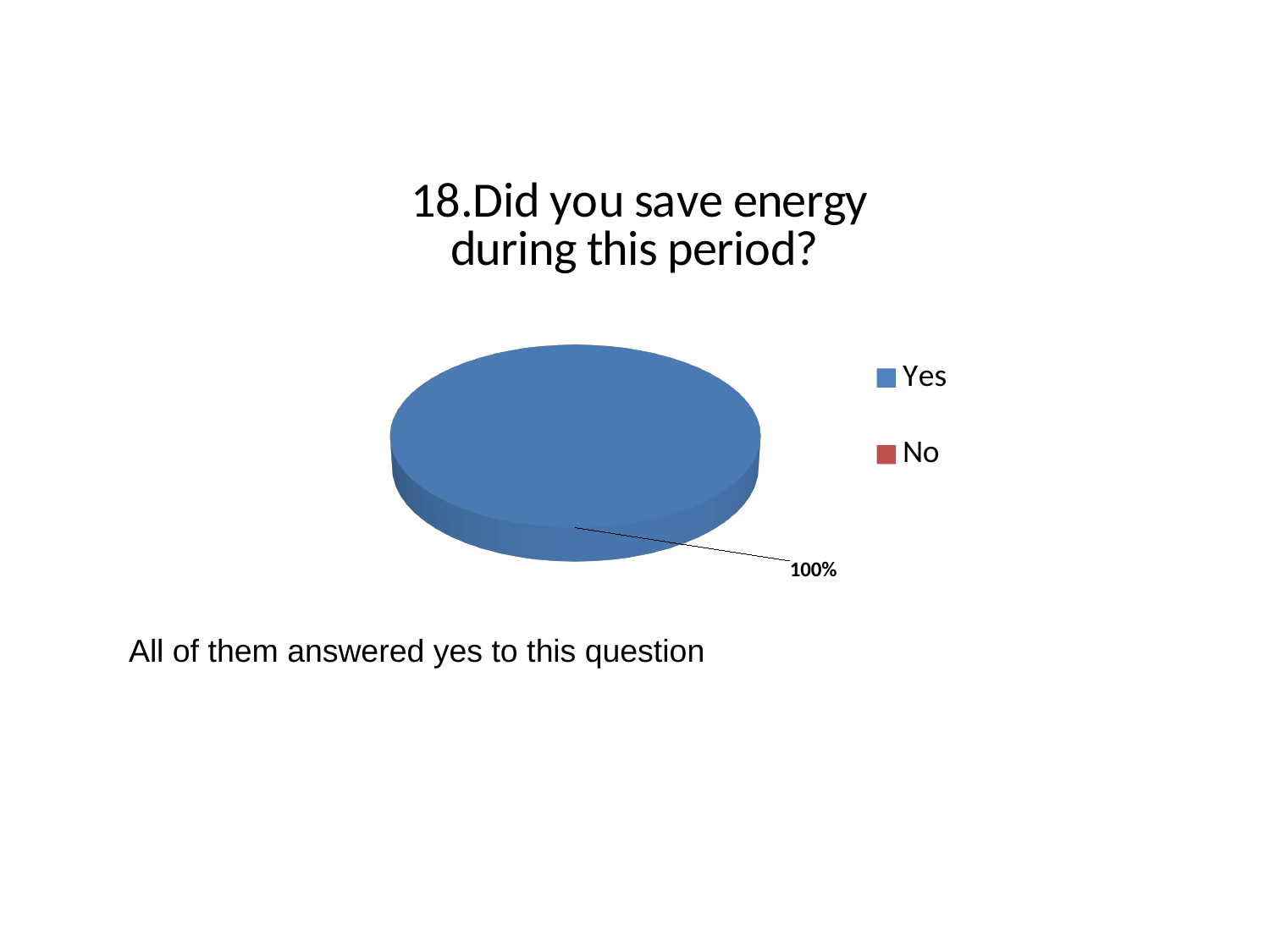
Which is larger, the share for Yes or the share for No? Yes What is the value shown for Yes? 100% How many entries does the legend list? 2 Is the share for Yes greater or less than 50%? greater What share of the pie does the Yes slice take? 100% What is the title of the chart? 18.Did you save energy during this period? What kind of chart is shown on the slide? pie chart What colour is the Yes slice? blue Which category has the largest share of the pie? Yes